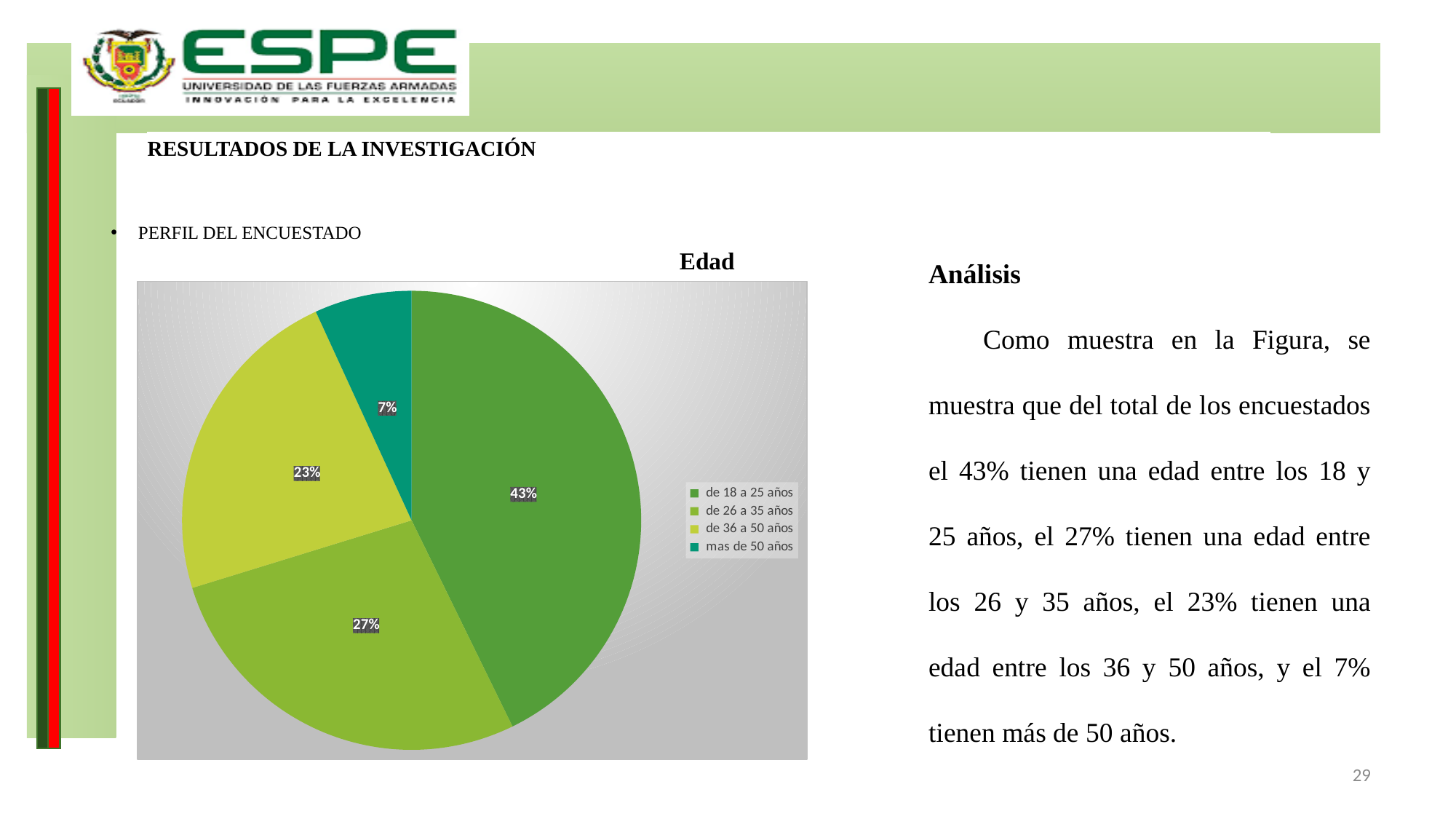
How many age categories does the pie chart show? 4 What share of respondents are 'de 36 a 50 años'? 23% What share of respondents are 'de 18 a 25 años'? 43% Which is larger: the share for 'de 26 a 35 años' or 'de 36 a 50 años'? de 26 a 35 años Which age group has the largest slice of the pie? de 18 a 25 años What share of respondents are 'de 26 a 35 años'? 27% What type of chart is shown on the slide? pie chart What is the title of the chart? Edad What is the difference in percentage points between 'de 18 a 25 años' and 'de 26 a 35 años'? 16 Which age group has the smallest slice of the pie? mas de 50 años What share of respondents are 'mas de 50 años'? 7% How many entries does the legend list? 4